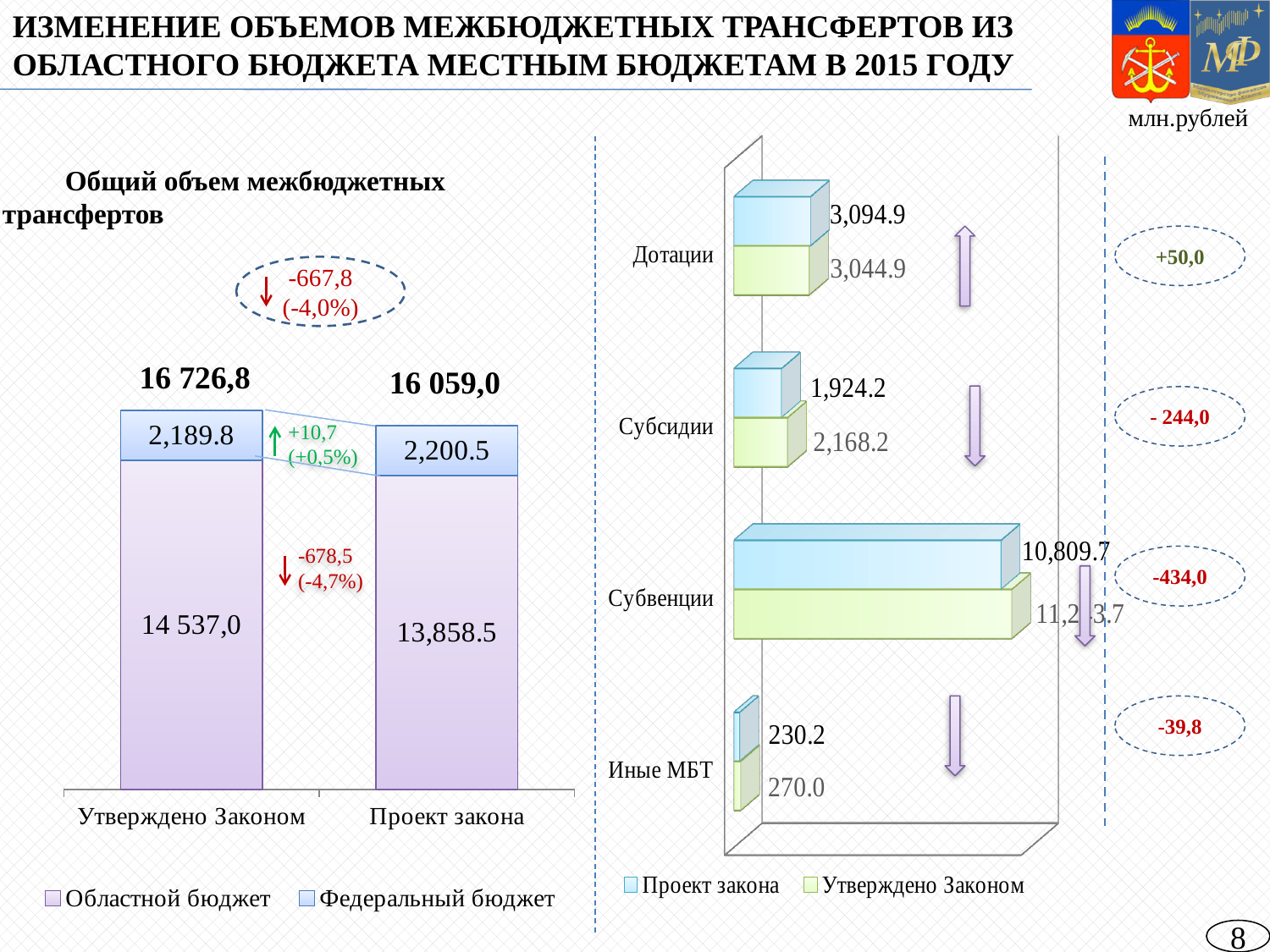
In the left chart (Общий объем межбюджетных трансфертов), what is the total of the stacked bar for Утверждено Законом? 16 726,8 In the left chart (Общий объем межбюджетных трансфертов), how many series does the legend list? 2 In the right chart, what is the Утверждено Законом value for Иные МБТ? 270.0 In the left chart (Общий объем межбюджетных трансфертов), what kind of chart is it? Stacked bar chart In the right chart, what is the Проект закона value for Дотации? 3,094.9 In the left chart (Общий объем межбюджетных трансфертов), what is the value of Областной бюджет for Утверждено Законом? 14 537,0 In the left chart (Общий объем межбюджетных трансфертов), what is the value of Федеральный бюджет for Проект закона? 2,200.5 In the right chart, how many categories are shown? 4 In the left chart (Общий объем межбюджетных трансфертов), which category has the larger Областной бюджет value, Утверждено Законом or Проект закона? Утверждено Законом In the right chart, what is the Утверждено Законом value for Субсидии? 2,168.2 In the right chart, what is the difference between the Проект закона and Утверждено Законом values for Иные МБТ? 39.8 In the right chart, which category has the highest Проект закона value? Субвенции